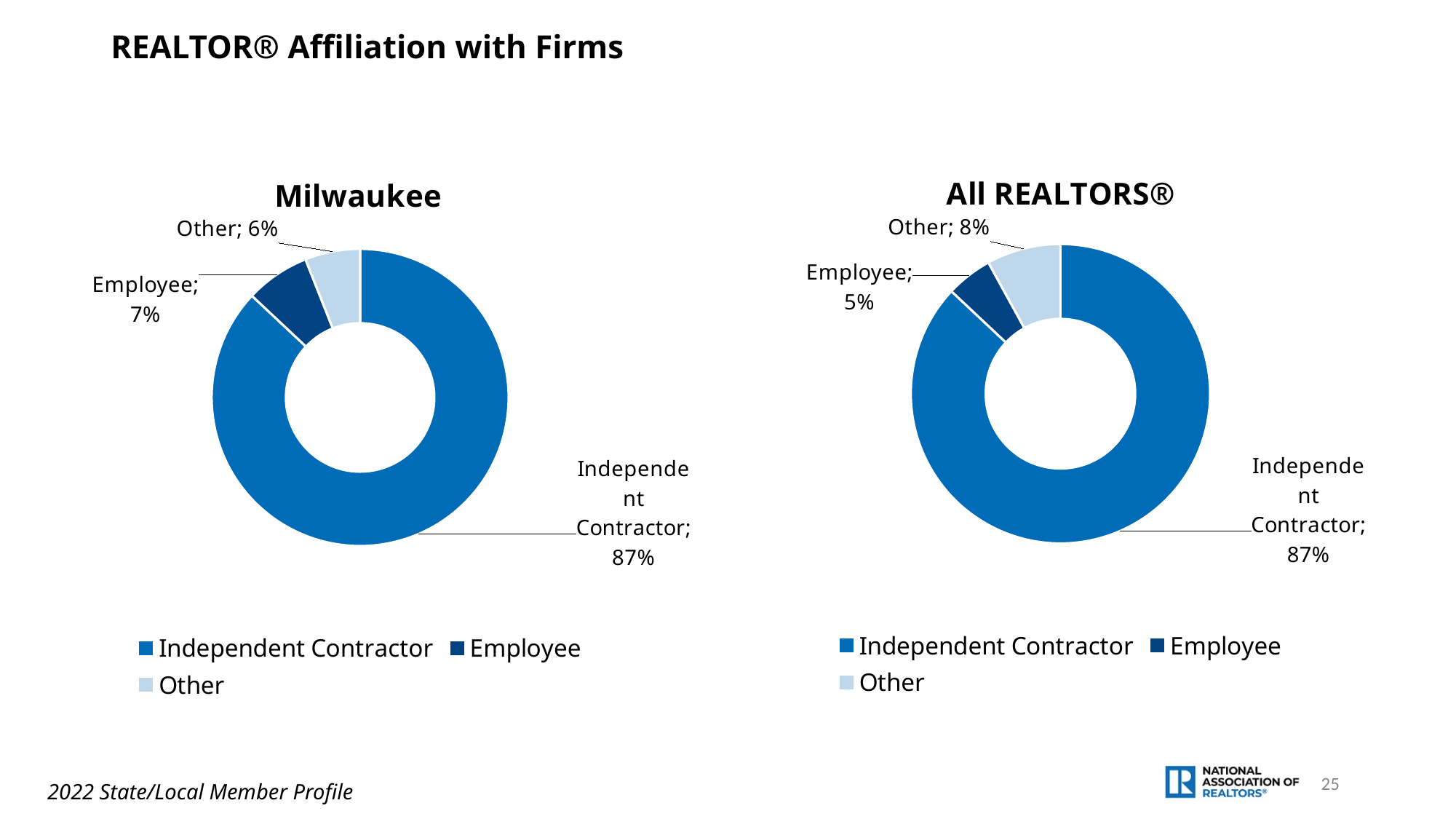
In the Milwaukee chart, what is the value for Employee? 7% In the Milwaukee chart, which category has the smallest share? Other In the Milwaukee chart, what is the difference between the Employee and Other shares? 1% How many categories does the Milwaukee chart show? 3 In the All REALTORS chart, which category has the largest share? Independent Contractor What is the title of the chart on the right side of the slide? All REALTORS® In the All REALTORS chart, what is the value for Other? 8% In the Milwaukee chart, what percentage of REALTORS are Independent Contractors? 87% Is the Employee share larger in the Milwaukee chart or the All REALTORS chart? Milwaukee How many entries does the legend of the Milwaukee chart list? 3 In the All REALTORS chart, what is the value for Employee? 5% What kind of chart is the All REALTORS chart? Doughnut (pie) chart